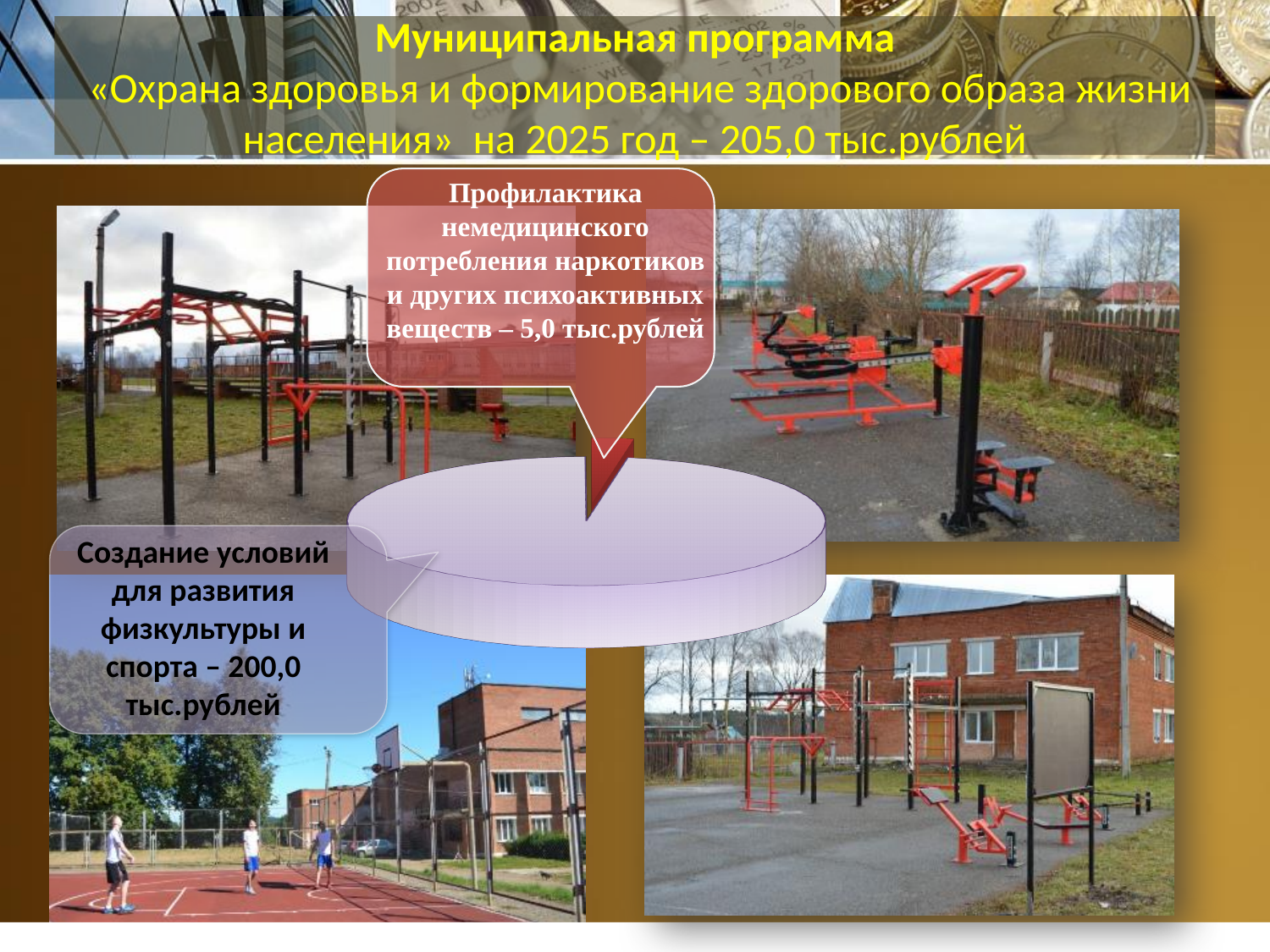
Which slice of the pie chart is the smallest? Профилактика немедицинского потребления наркотиков и других психоактивных веществ What is the difference between the value for «Создание условий для развития физкультуры и спорта» and the value for «Профилактика немедицинского потребления наркотиков»? 195,0 тыс.рублей What is the value for «Профилактика немедицинского потребления наркотиков и других психоактивных веществ»? 5,0 тыс.рублей Which slice of the pie chart is the largest? Создание условий для развития физкультуры и спорта What is the value for «Создание условий для развития физкультуры и спорта»? 200,0 тыс.рублей For which year is the municipal programme budget shown on the slide? 2025 How many slices does the pie chart have? 2 What is the name of the municipal programme in the slide title? «Охрана здоровья и формирование здорового образа жизни населения» What is the total of the two slices of the pie chart? 205,0 тыс.рублей Which is larger: the value for «Создание условий для развития физкультуры и спорта» or the value for «Профилактика немедицинского потребления наркотиков»? Создание условий для развития физкультуры и спорта What kind of chart is shown on the slide? Pie chart